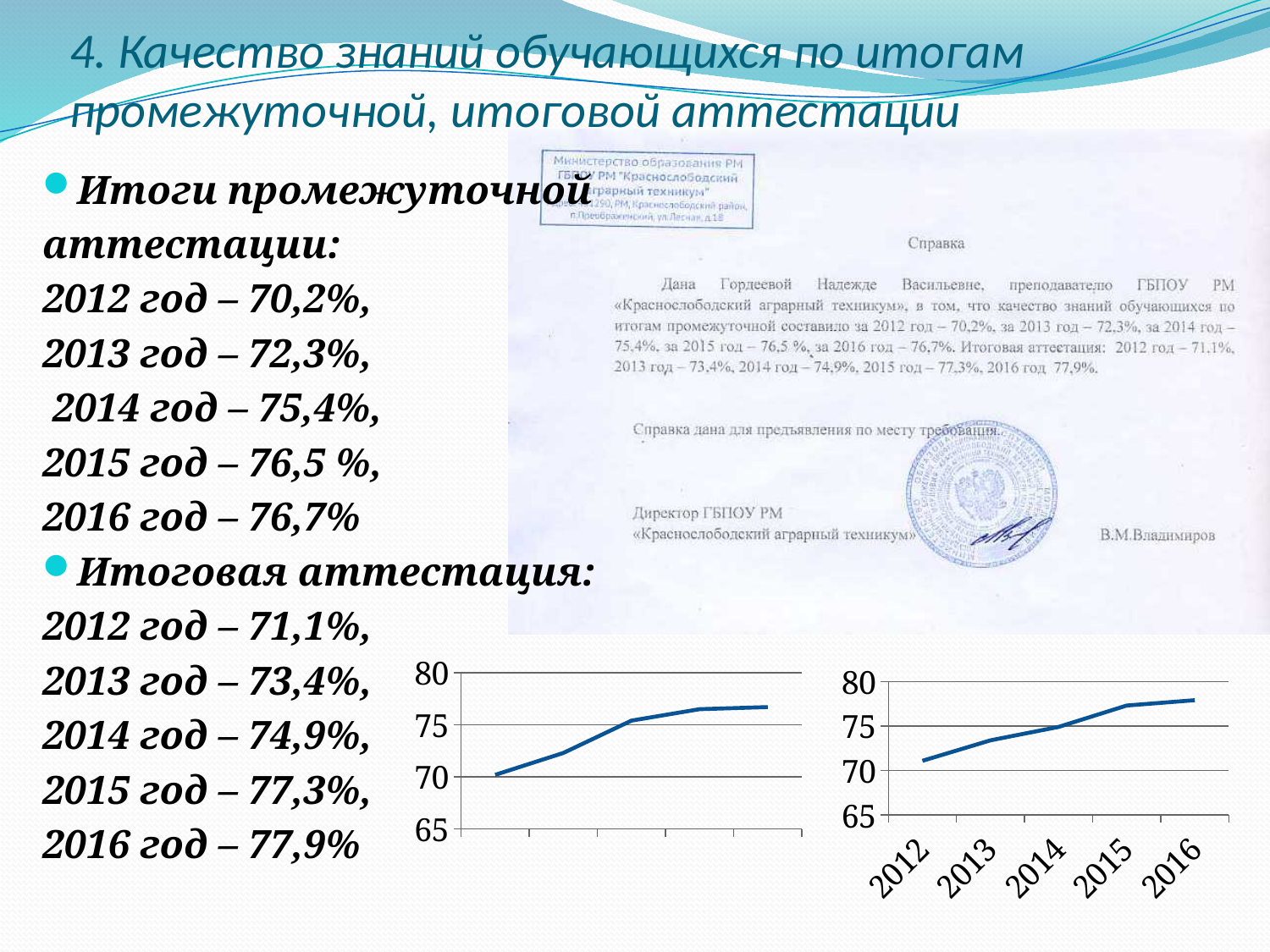
In the bottom-left chart, do the values rise or fall from left to right? rise In the bottom-right chart, is the value for 2013 greater or less than 75? less What kind of chart is the chart on the bottom right of the slide? line chart In the bottom-right chart, do the values rise or fall from 2012 to 2016? rise In the bottom-right chart, is the value for 2016 greater or less than 80? less In the bottom-right chart, is the value for 2016 greater or less than 75? greater In the bottom-right chart, how many years are shown on the x axis? 5 In the bottom-right chart, which year has the lowest value? 2012 In the bottom-right chart, which is larger, the value for 2013 or the value for 2015? 2015 What kind of chart is the chart on the bottom left of the slide? line chart